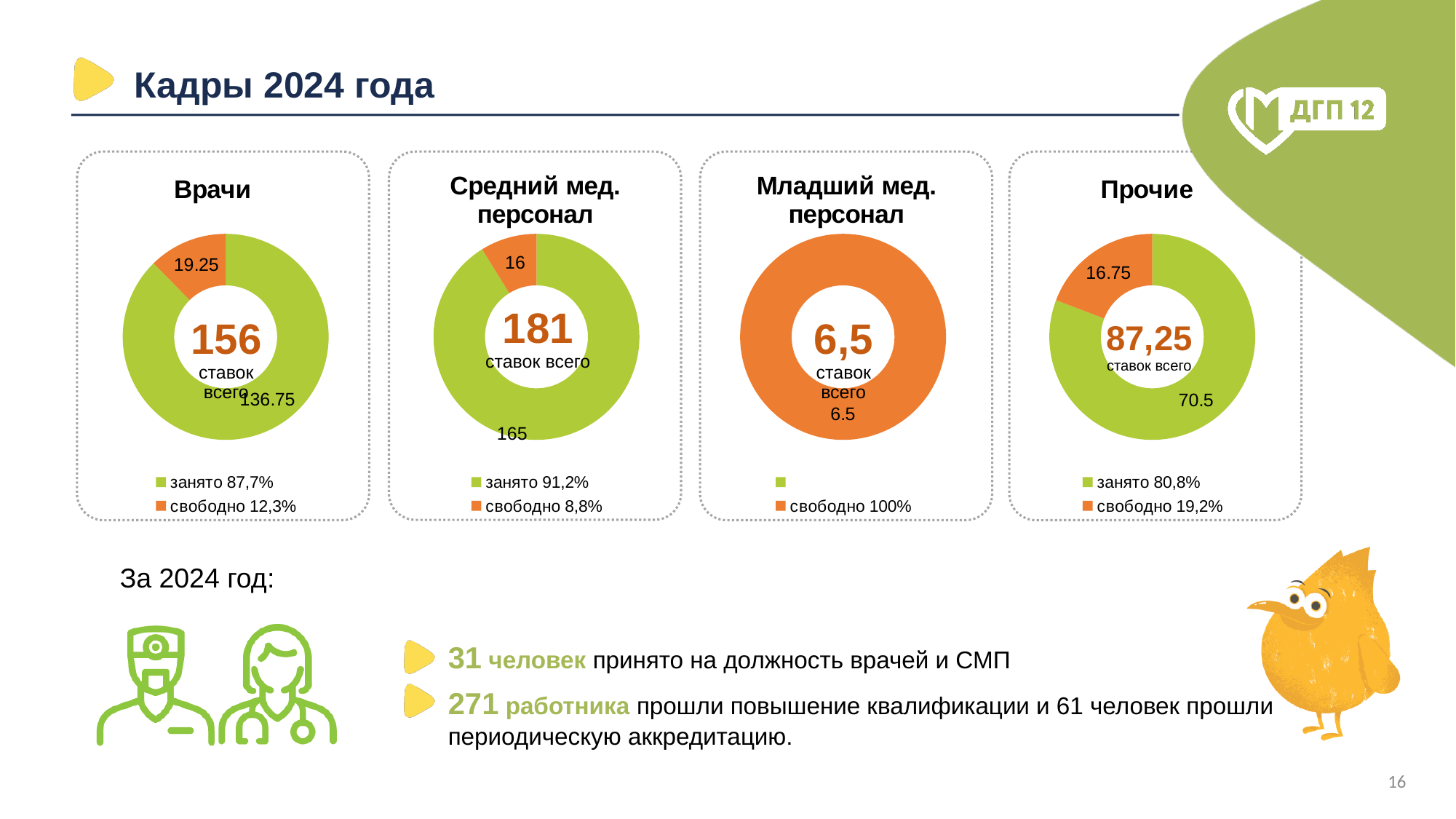
What kind of chart is used for 'Врачи'? pie chart (donut) Which chart shows the largest total number of 'ставок всего'? Средний мед. персонал On the 'Прочие' chart, what is the value of the 'свободно' slice? 16.75 On the 'Прочие' chart, what share of the total is 'свободно' according to the legend? 19,2% On the 'Средний мед. персонал' chart, what share is 'свободно' according to the legend? 8,8% On the 'Младший мед. персонал' chart, what value is shown for the 'свободно' slice? 6.5 On the 'Средний мед. персонал' chart, which slice is larger, 'занято' or 'свободно'? занято On the 'Средний мед. персонал' chart, what is the value of the 'занято' slice? 165 On the 'Врачи' chart, what is the difference between the 'занято' value (136.75) and the 'свободно' value (19.25)? 117.5 How many charts are shown on the slide? 4 On the 'Врачи' chart, what share of the total is 'занято' according to the legend? 87,7% On the 'Врачи' chart, what is the value of the 'свободно' slice? 19.25